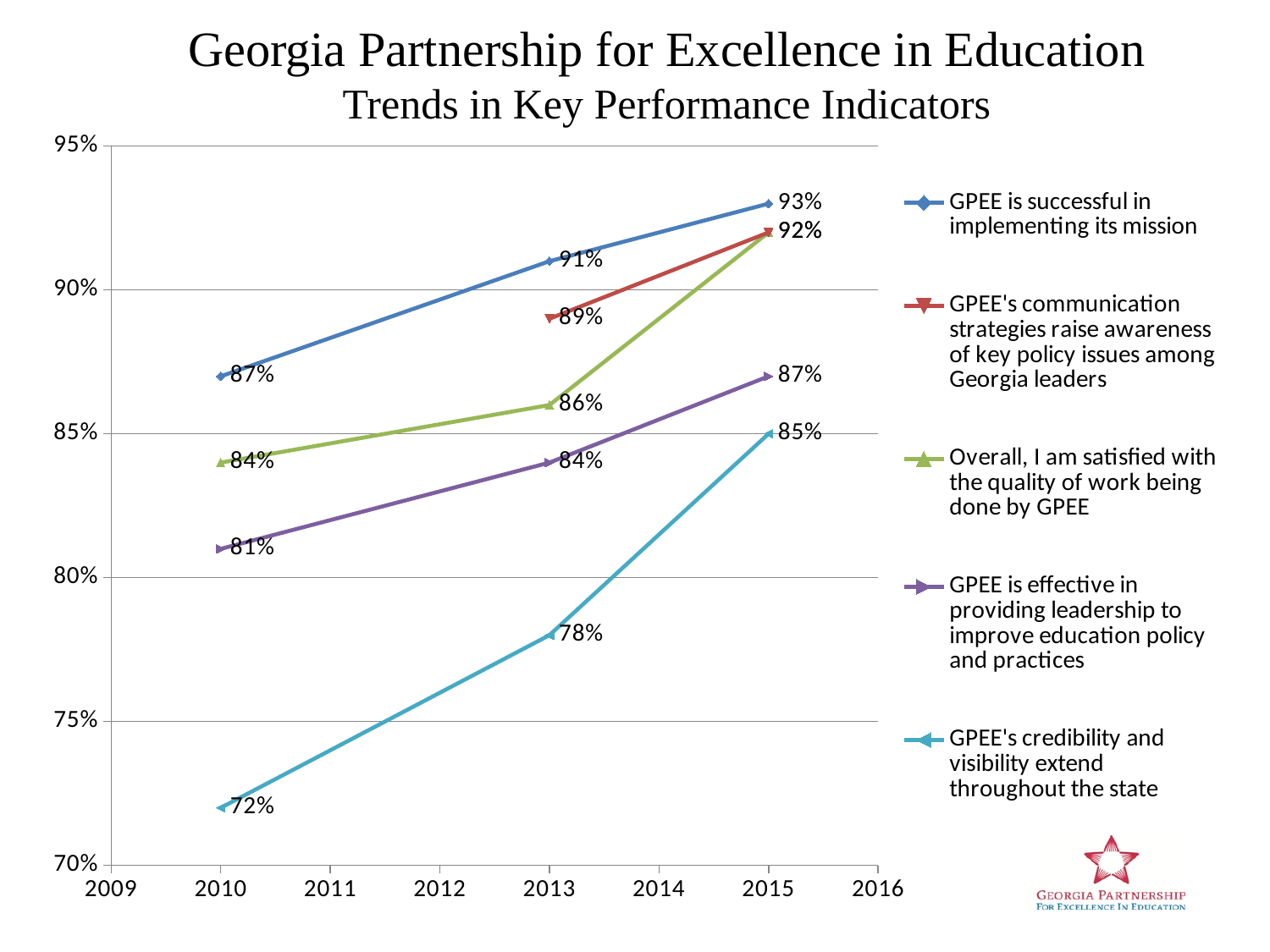
What is the difference between the 2015 and 2010 values for 'GPEE's credibility and visibility extend throughout the state'? 13% What kind of chart is shown on the slide? Line chart Do the values for 'Overall, I am satisfied with the quality of work being done by GPEE' rise or fall from 2010 to 2015? Rise Which series has the highest value in 2015? GPEE is successful in implementing its mission How many data points are plotted for 'GPEE is successful in implementing its mission'? 3 What is the value for 'GPEE's credibility and visibility extend throughout the state' in 2010? 72% How many series does the legend list? 5 What is the value for 'GPEE is effective in providing leadership to improve education policy and practices' in 2013? 84% What is the value for 'GPEE's communication strategies raise awareness of key policy issues among Georgia leaders' in 2013? 89% Which is larger in 2013: the value for 'Overall, I am satisfied with the quality of work being done by GPEE' or the value for 'GPEE is effective in providing leadership to improve education policy and practices'? Overall, I am satisfied with the quality of work being done by GPEE Which series has the lowest value in 2010? GPEE's credibility and visibility extend throughout the state What is the value for 'GPEE is successful in implementing its mission' in 2015? 93%